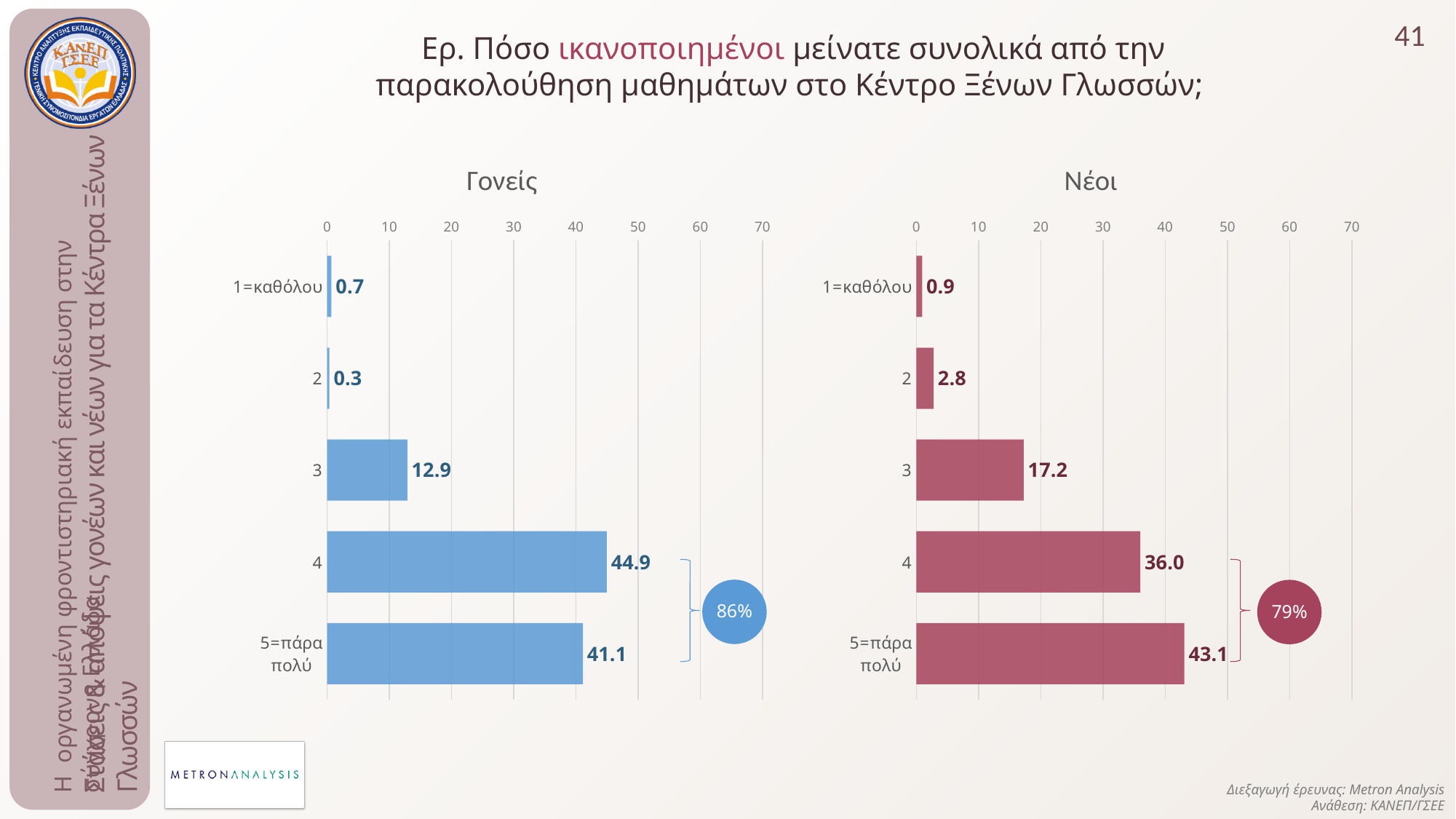
What type of chart is the Νέοι chart? bar chart In the Νέοι chart, is the value for category 4 greater or less than 30? greater In the Νέοι chart, what is the value for 5=πάρα πολύ? 43.1 In the Νέοι chart, what is the difference between the values for category 4 and category 3? 18.8 In the Νέοι chart, which category has the lowest value? 1=καθόλου In the Γονείς chart, what is the value for category 2? 0.3 In the Γονείς chart, what is the value for category 4? 44.9 In the Γονείς chart, which category has the highest value? 4 What percentage is shown in the circle next to the bracket in the Νέοι chart? 79% How many categories does the Γονείς chart show? 5 What colour are the bars in the Γονείς chart? blue In the Γονείς chart, which is larger: the value for category 3 or the value for 5=πάρα πολύ? 5=πάρα πολύ